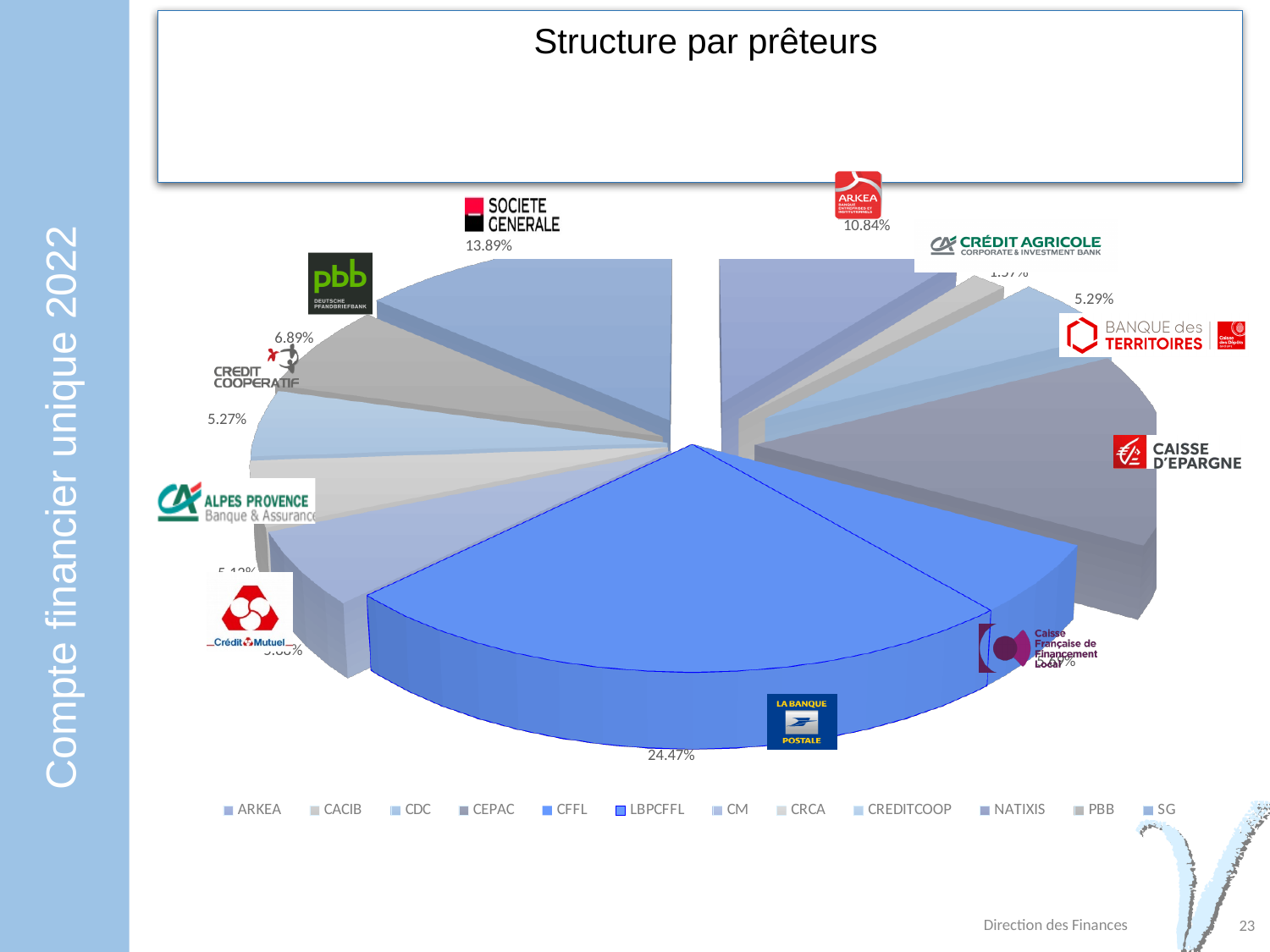
What percentage is shown next to the Société Générale logo? 13.89% What kind of chart is shown on the slide? pie chart How many entries does the chart legend list? 12 What percentage is shown next to the ARKEA logo? 10.84% What is the difference in percentage points between the largest slice (24.47%) and the Société Générale slice (13.89%)? 10.58 What is the title of the chart? Structure par prêteurs What is the percentage shown on the largest slice of the pie (next to the La Banque Postale logo)? 24.47% What percentage is shown next to the Banque des Territoires logo? 5.29% Which legend entry is listed first in the chart legend? ARKEA What percentage is shown next to the pbb (Deutsche Pfandbriefbank) logo? 6.89% What percentage is shown next to the Crédit Coopératif logo? 5.27% Which is larger: the share next to the Société Générale logo or the share next to the ARKEA logo? Société Générale